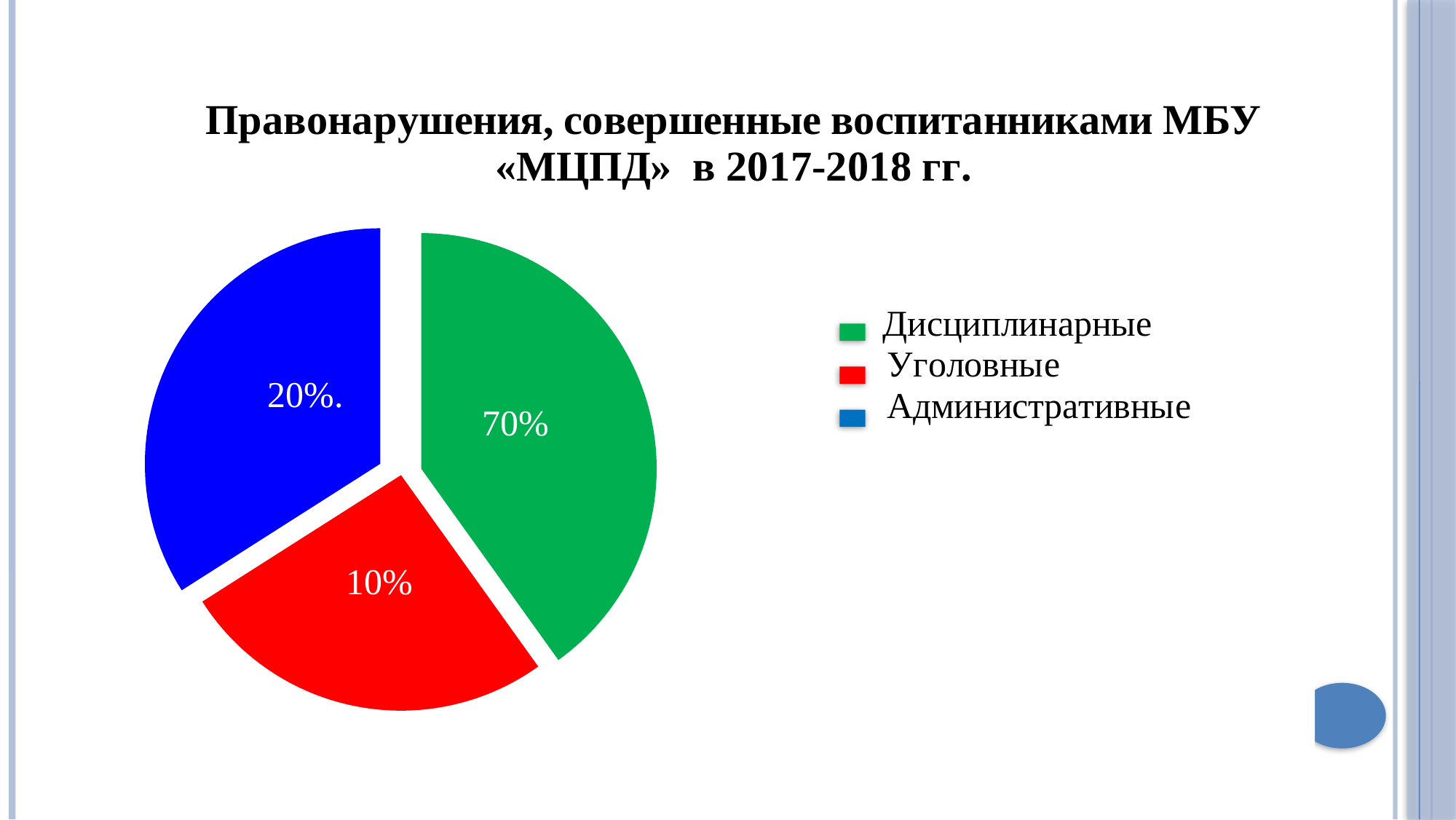
What type of chart is shown on the slide? Pie chart What is the difference in percentage points between Административные and Уголовные? 10 Which is larger, the share for Уголовные or the share for Административные? Административные Which category has the smallest slice of the pie? Уголовные What share of the pie does Дисциплинарные take? 70% Which category has the largest slice of the pie? Дисциплинарные What share of the pie does Уголовные take? 10% How many categories does the pie chart have? 3 What is the title of the chart? Правонарушения, совершенные воспитанниками МБУ «МЦПД» в 2017-2018 гг. What is the difference in percentage points between Дисциплинарные and Административные? 50 What colour is the slice for Уголовные? Red What share of the pie does Административные take? 20%